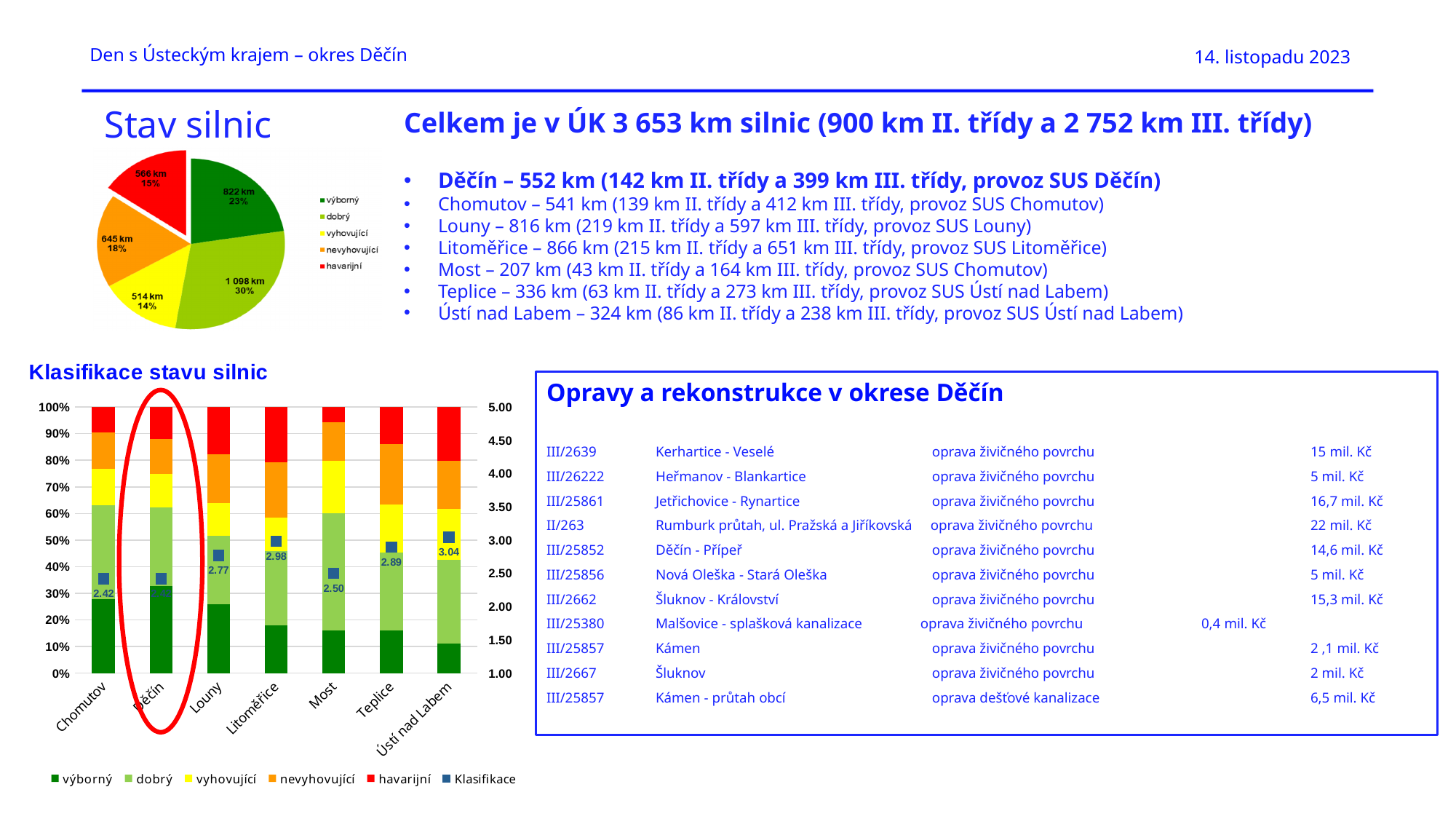
In the bar chart 'Klasifikace stavu silnic', how many districts are shown on the x axis? 7 In the pie chart 'Stav silnic', which category has the smallest slice? vyhovující In the pie chart 'Stav silnic', what value is shown for the 'dobrý' slice? 1 098 km In the bar chart 'Klasifikace stavu silnic', which district has the highest Klasifikace value? Ústí nad Labem In the bar chart 'Klasifikace stavu silnic', which has the larger Klasifikace value, Louny or Most? Louny In the pie chart 'Stav silnic', which category has the largest slice? dobrý In the bar chart 'Klasifikace stavu silnic', what is the Klasifikace value for Litoměřice? 2.98 In the pie chart 'Stav silnic', how many categories does the legend list? 5 In the pie chart 'Stav silnic', what is the difference in km between the 'výborný' and 'havarijní' slices? 256 km In the pie chart 'Stav silnic', what percentage share does the 'havarijní' slice have? 15% What type of chart is 'Klasifikace stavu silnic'? a 100% stacked bar chart combined with a line/marker series (Klasifikace) In the bar chart 'Klasifikace stavu silnic', what is the Klasifikace value for Ústí nad Labem? 3.04